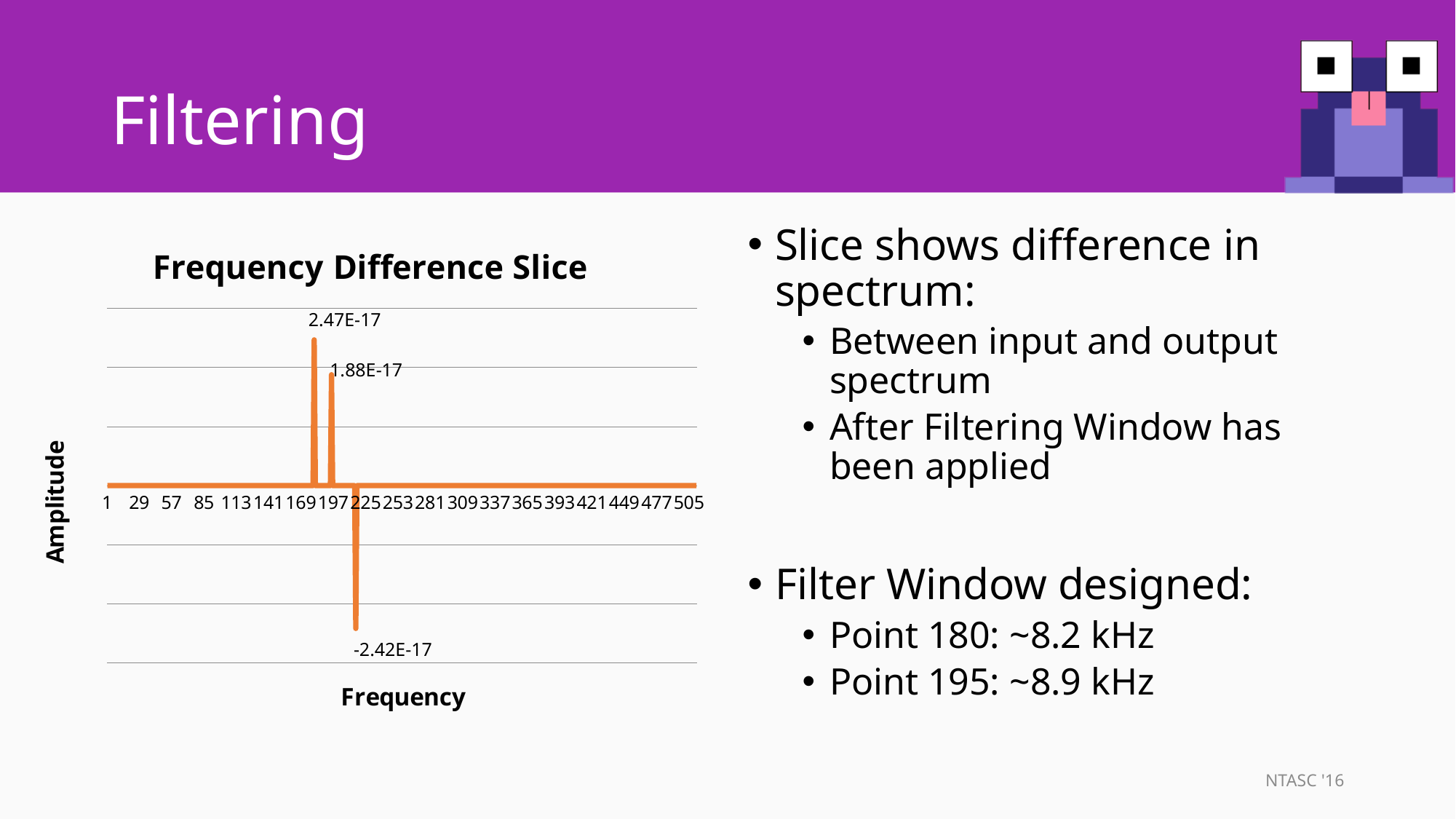
What are the x-axis and y-axis titles of the chart? Frequency (x-axis) and Amplitude (y-axis) What is the value of the second labeled positive peak on the chart? 1.88E-17 What is the first tick label on the x-axis of the chart? 1 What is the lowest data value labeled on the chart? -2.42E-17 What is the highest data value labeled on the chart? 2.47E-17 What is the title of the chart on the slide? Frequency Difference Slice How many data points on the chart have printed value labels? 3 Is the labeled negative spike on the chart greater or less than 0? less What kind of chart is shown on the slide? line chart What is the last tick label on the x-axis of the chart? 505 How many tick labels are shown on the x-axis of the chart? 19 Which is larger, the first labeled peak (2.47E-17) or the second labeled peak (1.88E-17)? 2.47E-17